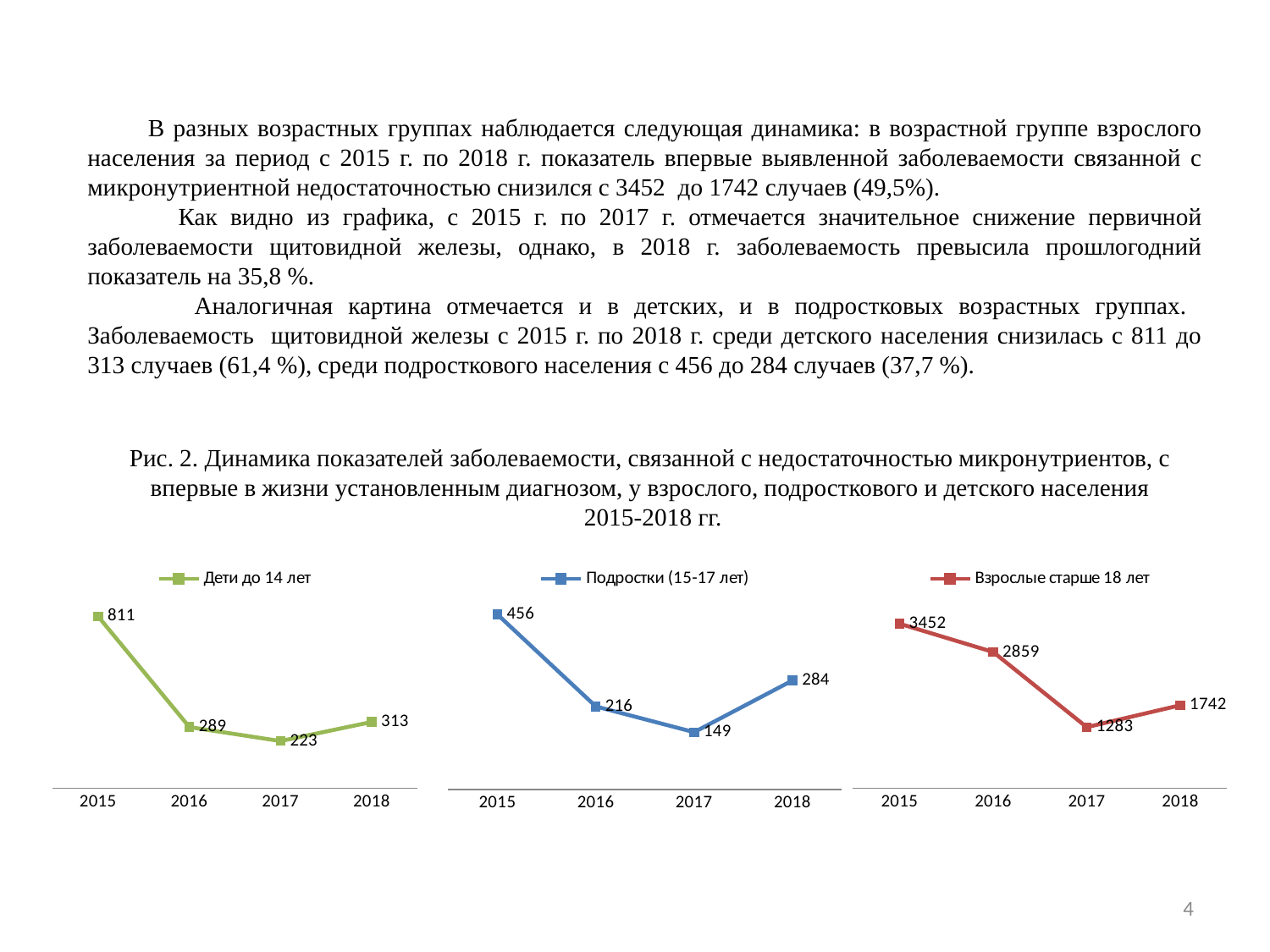
What type of chart is used for the Взрослые старше 18 лет data? Line chart In the right chart (Взрослые старше 18 лет), do the values rise or fall from 2015 to 2017? Fall In the right chart (Взрослые старше 18 лет), what is the difference between the 2015 and 2018 values? 1710 In the right chart (Взрослые старше 18 лет), which year has the lowest value? 2017 In the left chart (Дети до 14 лет), which year has the highest value? 2015 In the middle chart (Подростки (15-17 лет)), what is the difference between the 2015 and 2018 values? 172 In the left chart (Дети до 14 лет), what is the value for 2015? 811 In the left chart (Дети до 14 лет), which is larger: the value for 2016 or the value for 2018? 2018 How many data points are plotted in the middle chart (Подростки (15-17 лет))? 4 What is the legend entry of the middle chart? Подростки (15-17 лет) In the right chart (Взрослые старше 18 лет), what is the value for 2016? 2859 In the middle chart (Подростки (15-17 лет)), what is the value for 2017? 149